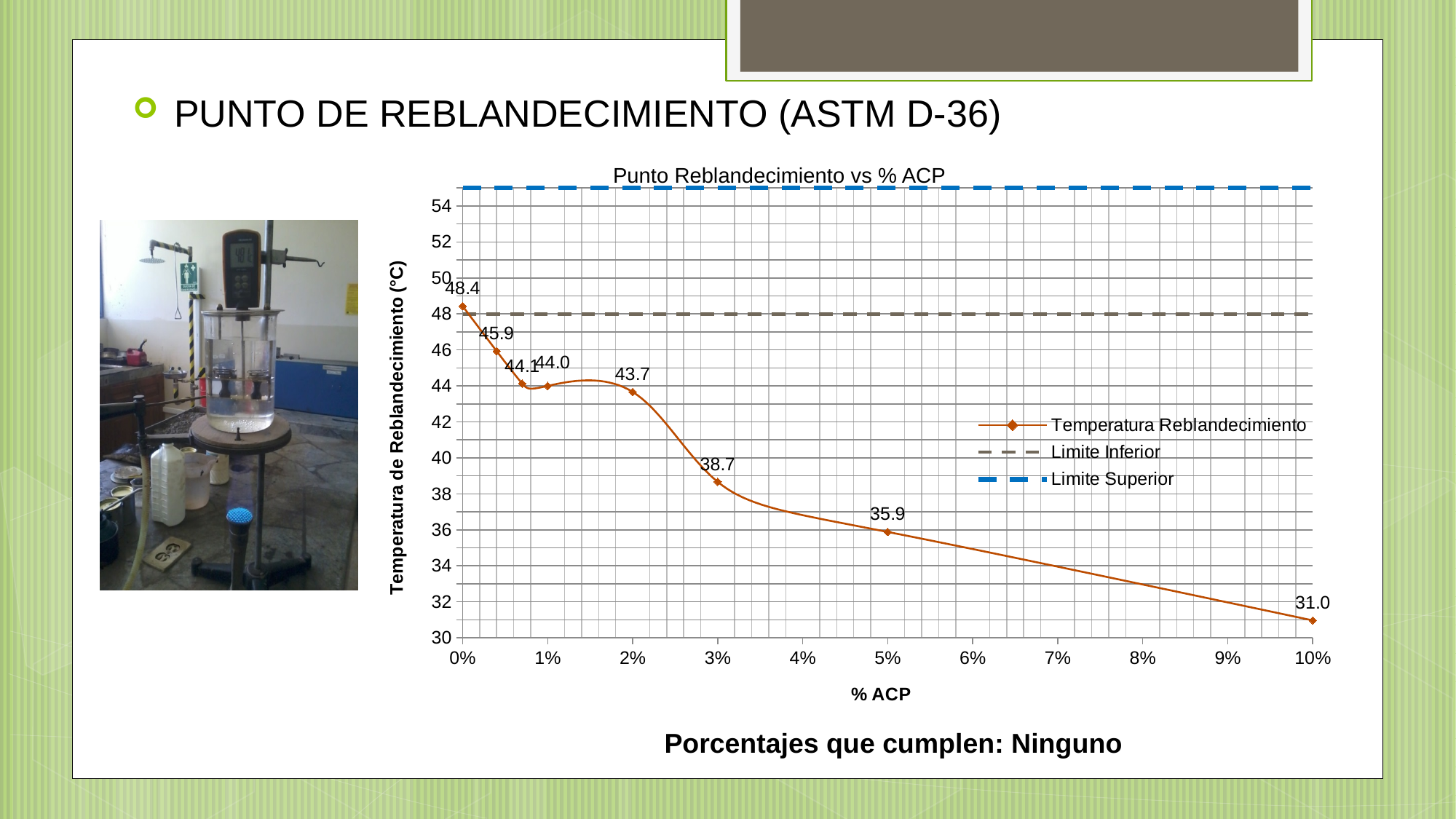
Is the Limite Superior line greater or less than 54? greater Does the Temperatura Reblandecimiento rise or fall as % ACP increases? fall What is the Temperatura Reblandecimiento at 0% ACP? 48.4 At which % ACP is the Temperatura Reblandecimiento highest? 0% What is the Temperatura Reblandecimiento at 5% ACP? 35.9 Which has a higher Temperatura Reblandecimiento, 2% ACP or 3% ACP? 2% ACP What is the Temperatura Reblandecimiento at 10% ACP? 31.0 What type of chart is shown? line chart What is the Temperatura Reblandecimiento at 3% ACP? 38.7 What is the lowest Temperatura Reblandecimiento value plotted? 31.0 How many series does the legend list? 3 What is the difference between the Temperatura Reblandecimiento at 0% ACP and at 10% ACP? 17.4